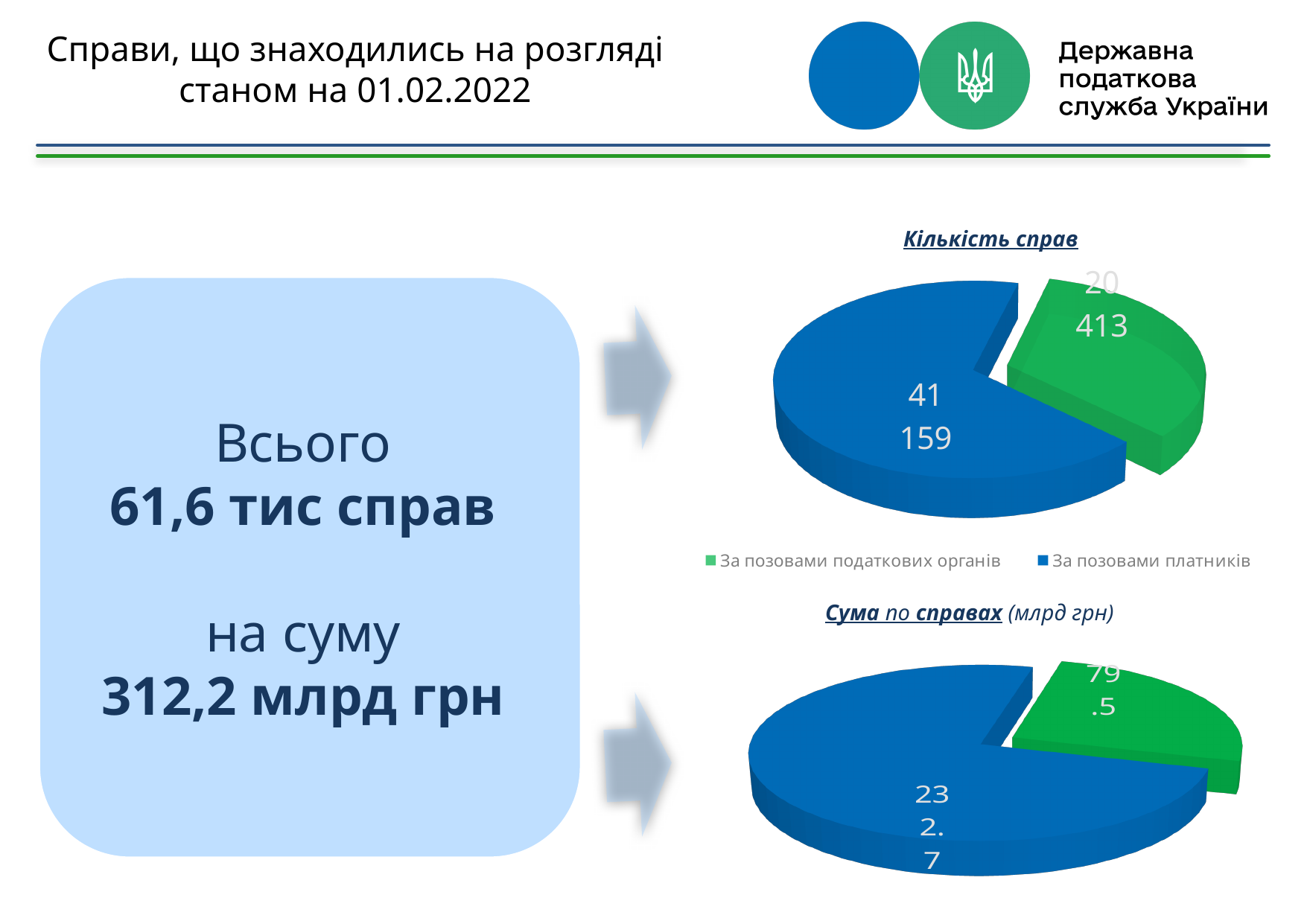
In the "Кількість справ" chart, which category has the largest slice? За позовами платників In the "Сума по справах (млрд грн)" chart, what is the value of the blue slice? 232.7 In the "Кількість справ" chart, what is the difference between "За позовами платників" and "За позовами податкових органів"? 20 746 In the "Сума по справах (млрд грн)" chart, which slice is larger, the blue one or the green one? the blue one In the "Сума по справах (млрд грн)" chart, what is the value of the green slice? 79.5 In the "Кількість справ" chart, what is the value for "За позовами платників"? 41 159 In the "Кількість справ" chart, what is the value for "За позовами податкових органів"? 20 413 How many slices does the "Кількість справ" pie chart have? 2 In the "Сума по справах (млрд грн)" chart, what is the difference between the blue slice and the green slice? 153.2 What kind of chart is the "Кількість справ" chart? pie chart What unit is given in the title of the lower pie chart? млрд грн How many entries does the legend below the "Кількість справ" chart list? 2